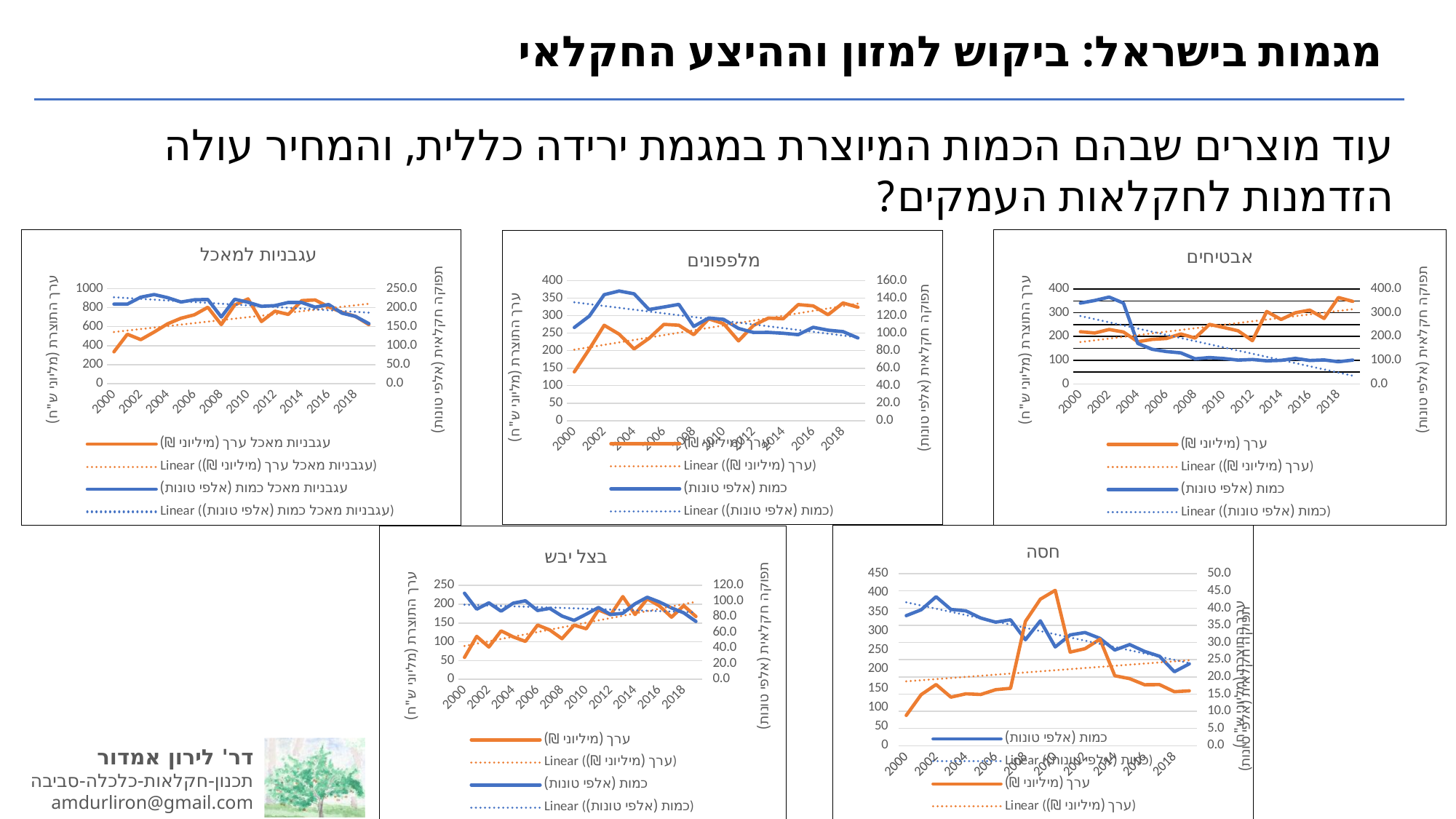
How many entries does the legend of the chart titled מלפפונים list? 4 How many charts are shown on the slide? 5 In the chart titled מלפפונים, is the value of ערך (מיליוני ₪) in 2000 greater or less than 200? less In the chart titled אבטיחים, is the value of כמות (אלפי טונות) in 2018 greater or less than 200? less In the chart titled אבטיחים, does the כמות (אלפי טונות) line rise or fall from 2000 to 2018? fall In the chart titled בצל יבש, is the value of ערך (מיליוני ₪) in 2000 greater or less than 100? less What is the title of the chart in the bottom-right of the slide? חסה In the chart titled חסה, does the כמות (אלפי טונות) line rise or fall from 2000 to 2018? fall In the chart titled מלפפונים, does the ערך (מיליוני ₪) line rise or fall overall from 2000 to 2018? rise What kind of chart is the chart titled אבטיחים? line chart